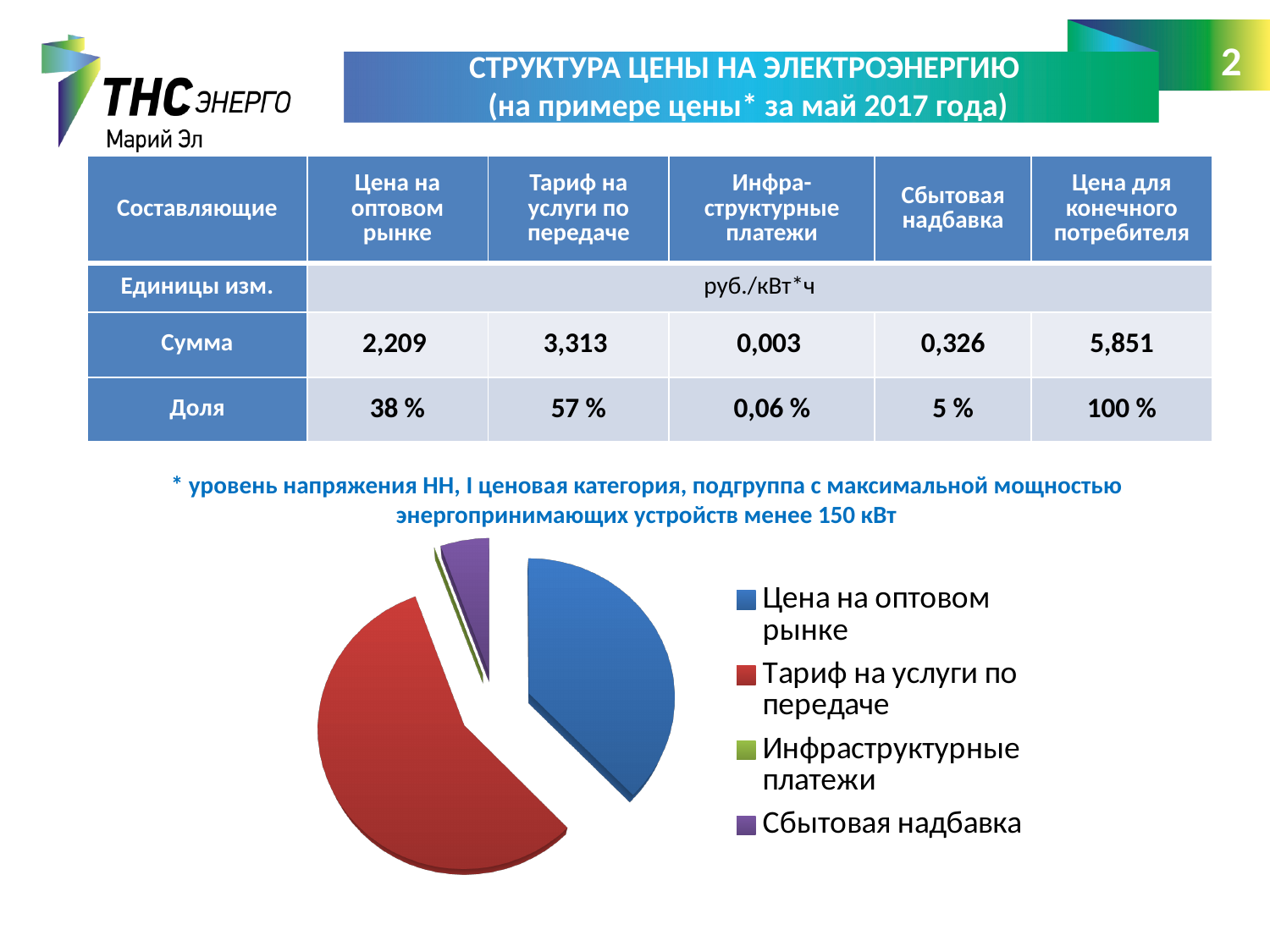
In the pie chart, which slice is larger: Сбытовая надбавка or Инфраструктурные платежи? Сбытовая надбавка How many entries does the pie chart's legend list? 4 Which component has the smallest slice in the pie chart? Инфраструктурные платежи What colour is the slice for Тариф на услуги по передаче in the pie chart? red What share of the pie does Сбытовая надбавка represent, according to the slide? 5 % How many slices does the pie chart have? 4 What share of the pie does Цена на оптовом рынке represent, according to the slide? 38 % What colour is the slice for Цена на оптовом рынке in the pie chart? blue Which component has the largest slice in the pie chart? Тариф на услуги по передаче What kind of chart is shown at the bottom of the slide? pie chart What share of the pie does Тариф на услуги по передаче represent, according to the slide? 57 % In the pie chart, which slice is larger: Цена на оптовом рынке or Тариф на услуги по передаче? Тариф на услуги по передаче